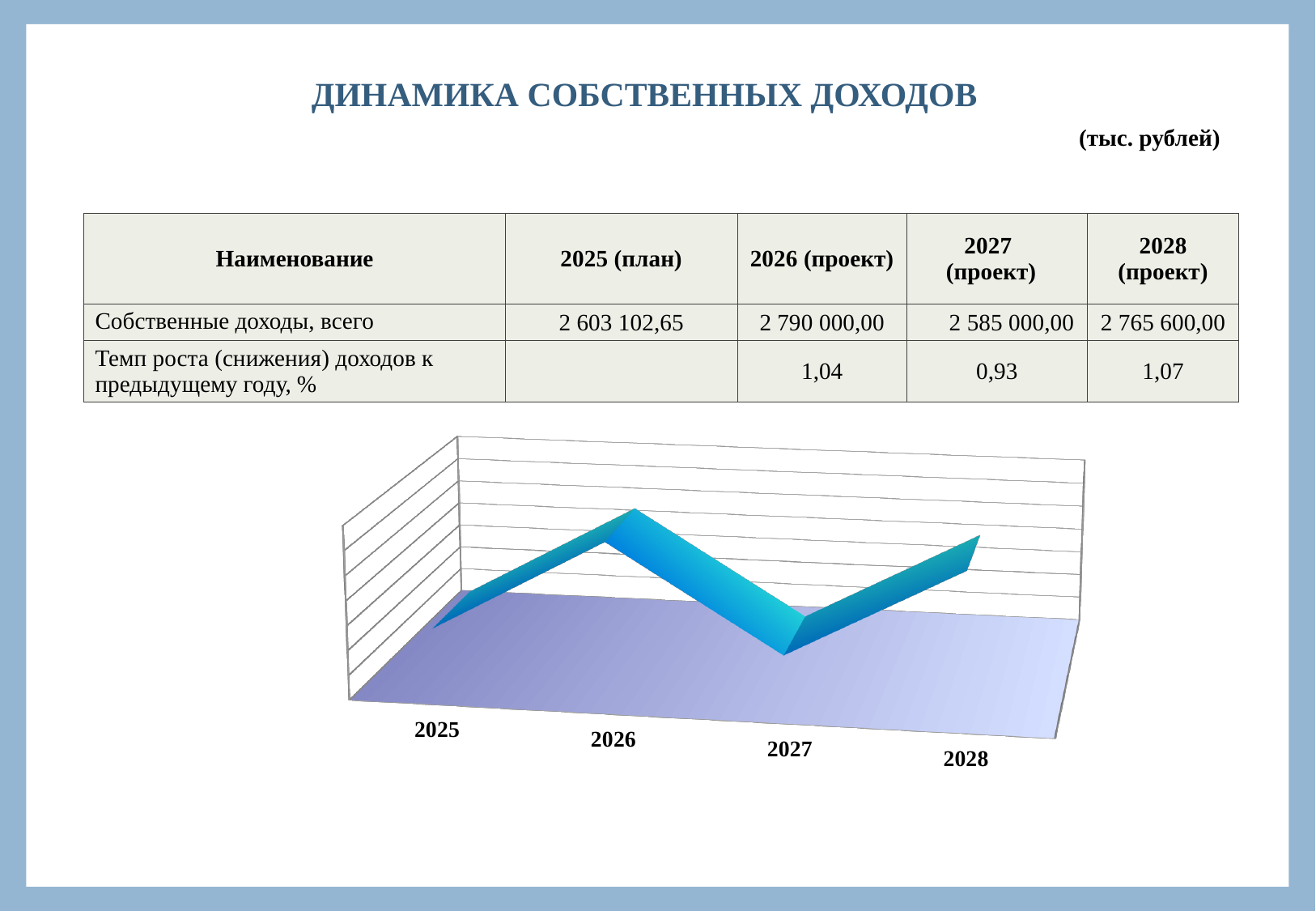
According to the table on the slide, what is the value of own revenues (Собственные доходы, всего) for 2026? 2 790 000,00 Does the line rise or fall from 2026 to 2027? Falls What is the title of the slide above the chart? ДИНАМИКА СОБСТВЕННЫХ ДОХОДОВ According to the table on the slide, what is the value of own revenues (Собственные доходы, всего) for 2028? 2 765 600,00 Does the line rise or fall from 2027 to 2028? Rises What are the first and last year labels on the chart's x axis? 2025 and 2028 What kind of chart is shown on the slide? Line chart How many years are plotted along the x axis of the chart? 4 Which is larger on the chart, the value for 2026 or the value for 2027? 2026 Which is larger on the chart, the value for 2028 or the value for 2027? 2028 Which year has the highest value on the chart? 2026 Does the line rise or fall from 2025 to 2026? Rises